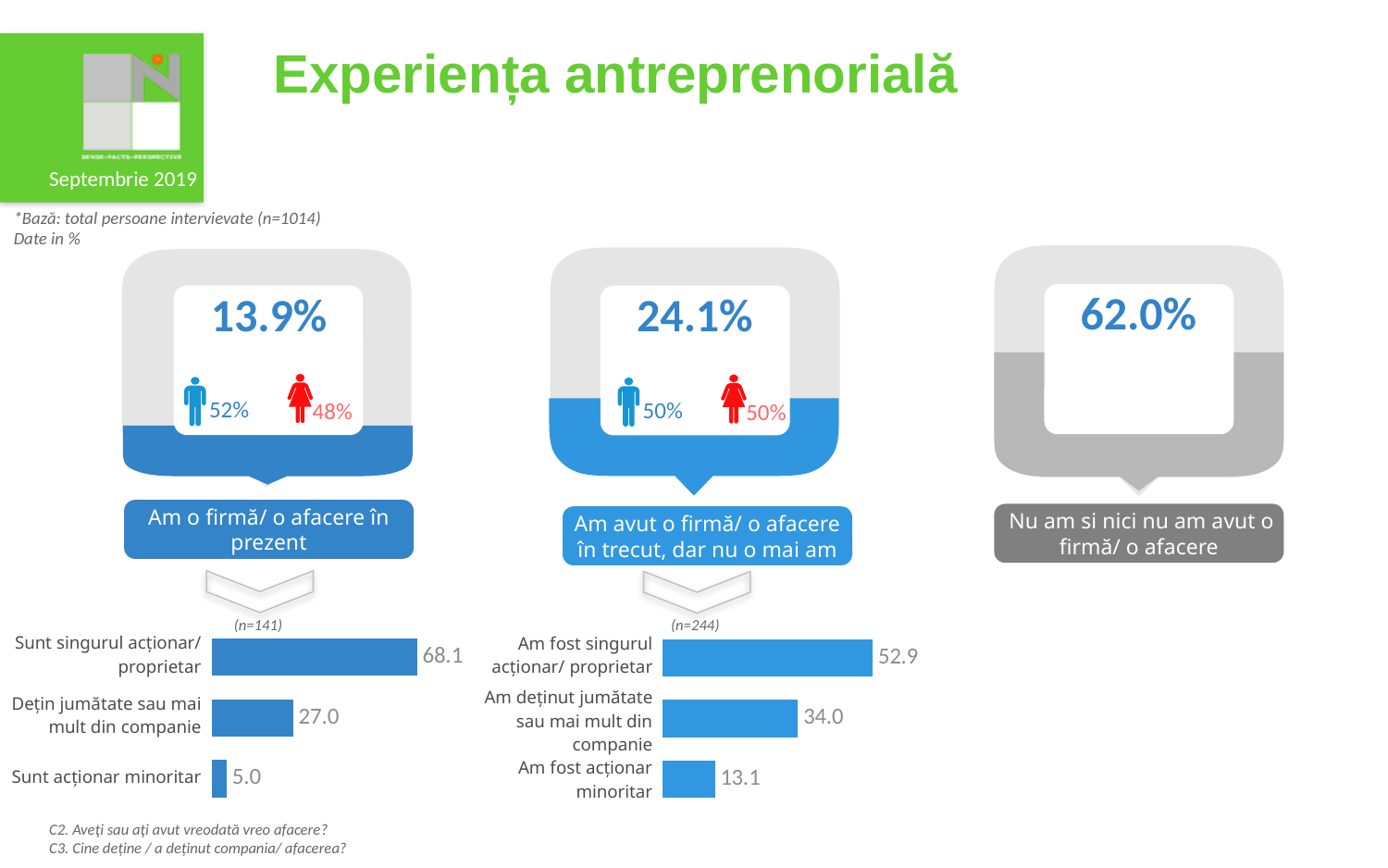
In the right bar chart (n=244), what is the value for "Am fost singurul acționar/ proprietar"? 52.9 In the right bar chart (n=244), what is the value for "Am fost acționar minoritar"? 13.1 In the left bar chart (n=141), what is the difference between "Sunt singurul acționar/ proprietar" and "Dețin jumătate sau mai mult din companie"? 41.1 In the left bar chart (n=141), what is the value for "Sunt acționar minoritar"? 5.0 In the right bar chart (n=244), which category has the lowest value? Am fost acționar minoritar Which is larger: "Sunt singurul acționar/ proprietar" in the left bar chart or "Am fost singurul acționar/ proprietar" in the right bar chart? Sunt singurul acționar/ proprietar (left chart) In the left bar chart (n=141), which category has the highest value? Sunt singurul acționar/ proprietar How many categories does the right bar chart (n=244) show? 3 In the left bar chart (n=141), what is the value for "Sunt singurul acționar/ proprietar"? 68.1 In the right bar chart (n=244), what is the value for "Am deținut jumătate sau mai mult din companie"? 34.0 In the left bar chart (n=141), what is the value for "Dețin jumătate sau mai mult din companie"? 27.0 What type of chart is used at the bottom of the slide for the ownership breakdown? Bar chart